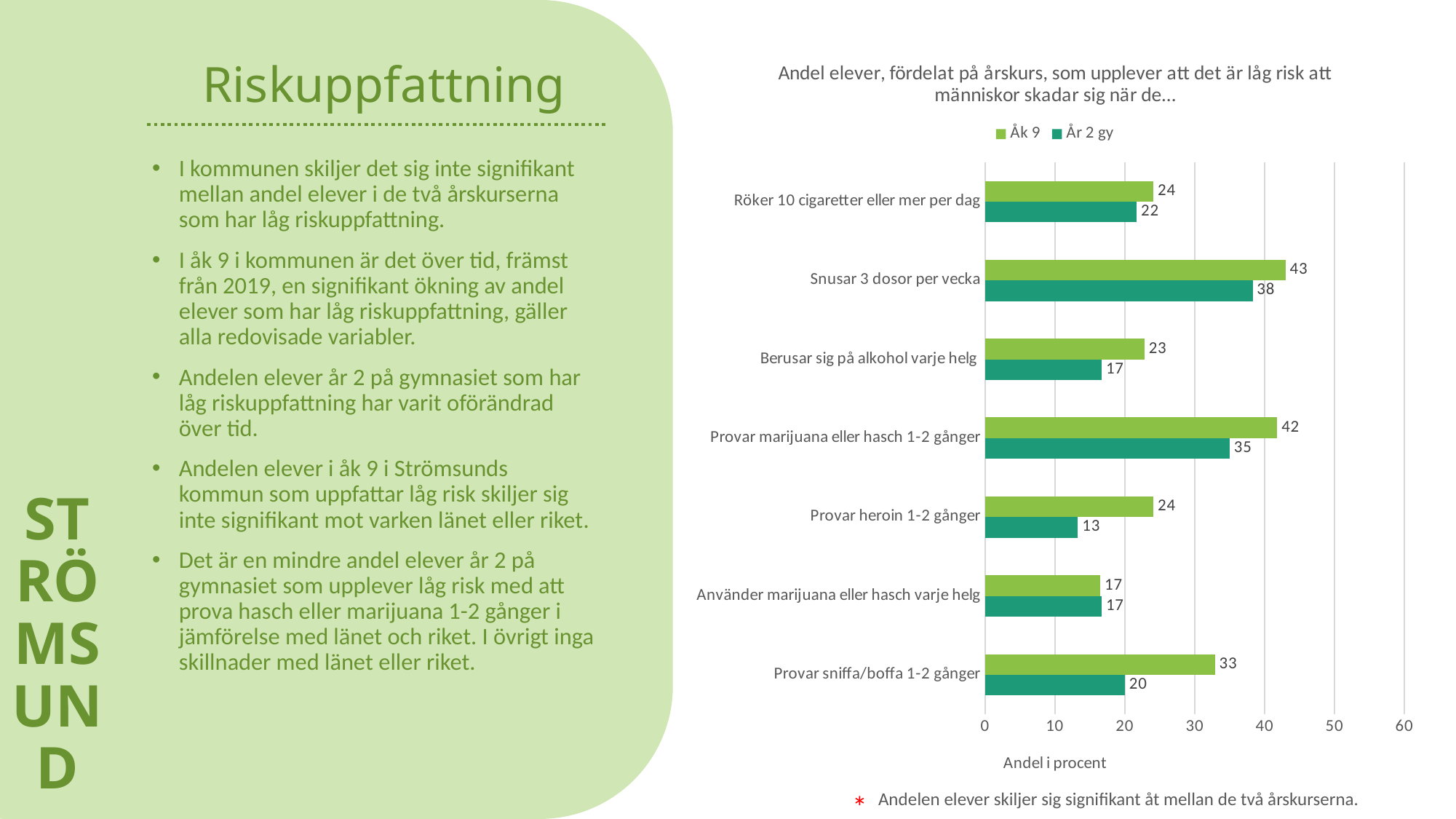
What is the difference between the Åk 9 and År 2 gy values for "Provar sniffa/boffa 1-2 gånger"? 13 What is the value for År 2 gy for "Provar sniffa/boffa 1-2 gånger"? 20 Which is larger for "Berusar sig på alkohol varje helg": the Åk 9 value or the År 2 gy value? Åk 9 Which category has the lowest value for År 2 gy? Provar heroin 1-2 gånger How many categories are shown on the chart? 7 Is the Åk 9 value for "Provar marijuana eller hasch 1-2 gånger" greater or less than 40? greater What is the value for År 2 gy for "Provar heroin 1-2 gånger"? 13 How many series does the legend list? 2 What is the value for Åk 9 for "Snusar 3 dosor per vecka"? 43 What kind of chart is shown on the slide? Bar chart Which category has the highest value for Åk 9? Snusar 3 dosor per vecka What is the label of the x axis? Andel i procent